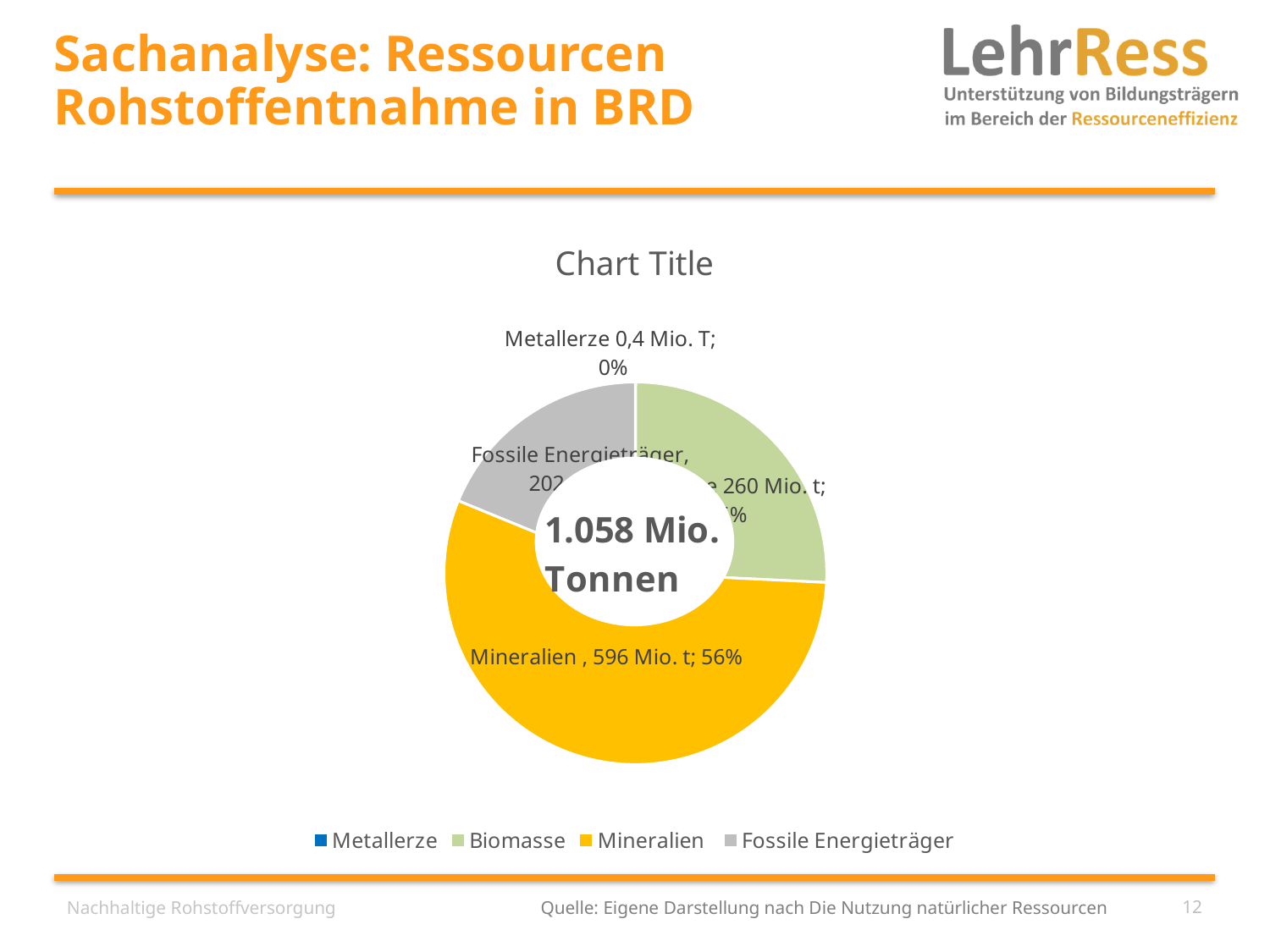
Which category has the smallest slice in the chart? Metallerze What kind of chart is shown on the slide? Doughnut (pie) chart What share of the chart does Mineralien represent? 56% What percentage share is shown for Metallerze? 0% What is the value shown for Mineralien in the chart? 596 Mio. t What is the value shown for Metallerze in the chart? 0,4 Mio. T Which category has the largest slice in the chart? Mineralien Which is larger, the slice for Mineralien or the slice for Biomasse? Mineralien What colour is the Mineralien slice in the chart? Yellow How many categories does the chart show? 4 What is the difference between the Mineralien value (596 Mio. t) and the Biomasse value (260 Mio. t)? 336 Mio. t What total is printed in the centre of the chart? 1.058 Mio. Tonnen